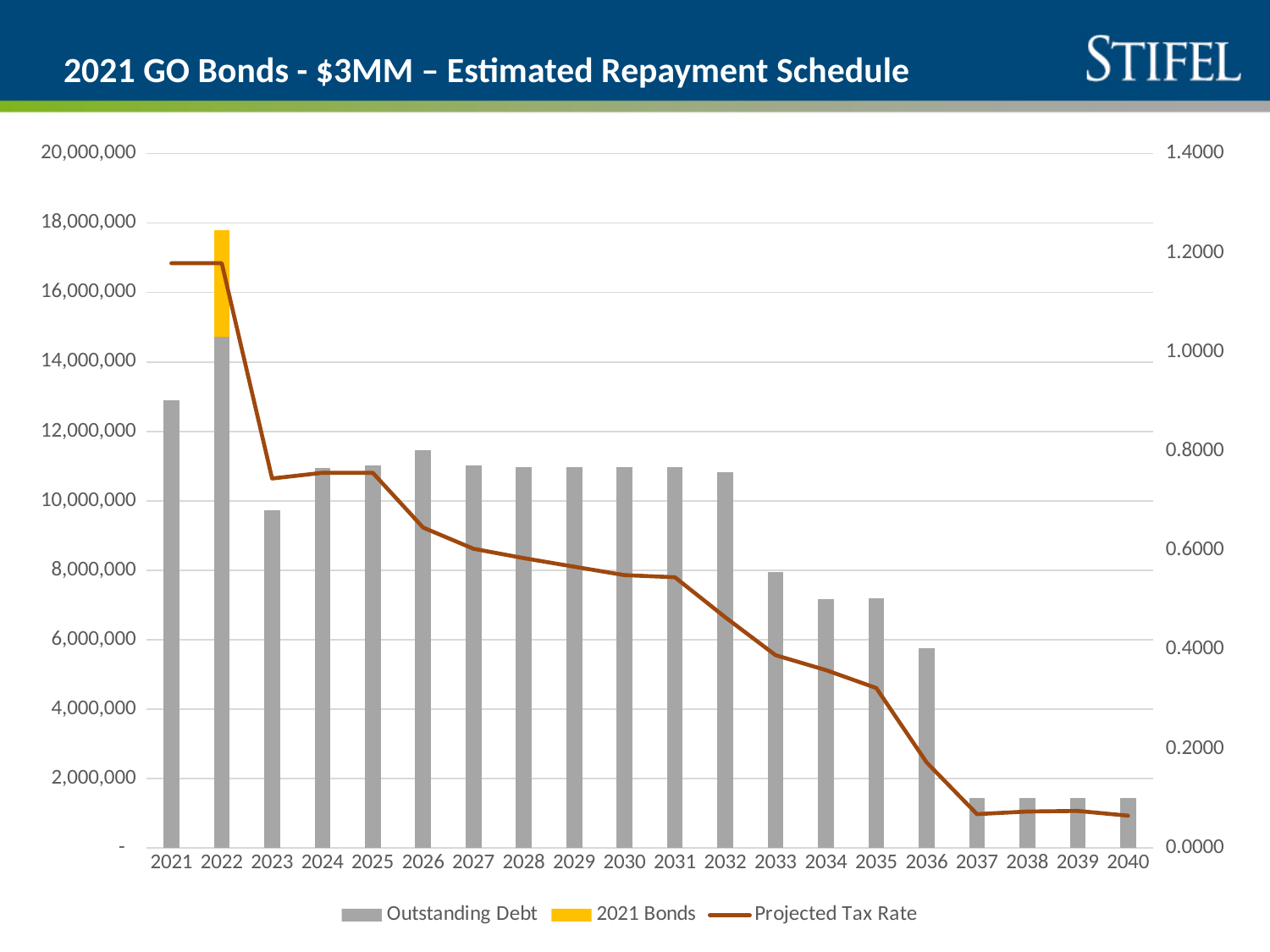
Does the Projected Tax Rate generally rise or fall from 2021 to 2040? fall Which year has the larger Outstanding Debt, 2021 or 2023? 2021 How many series does the legend list? 3 What kind of chart is this? Bar chart with a line Which year has the tallest Outstanding Debt bar? 2022 Which year has the larger Outstanding Debt, 2033 or 2036? 2033 Is the Projected Tax Rate for 2035 greater or less than 0.2000? greater Is the Outstanding Debt value for 2021 greater or less than 12,000,000? greater Is the Outstanding Debt value for 2023 greater or less than 10,000,000? less In which year does the 2021 Bonds series appear on the chart? 2022 How many years are shown on the x axis? 20